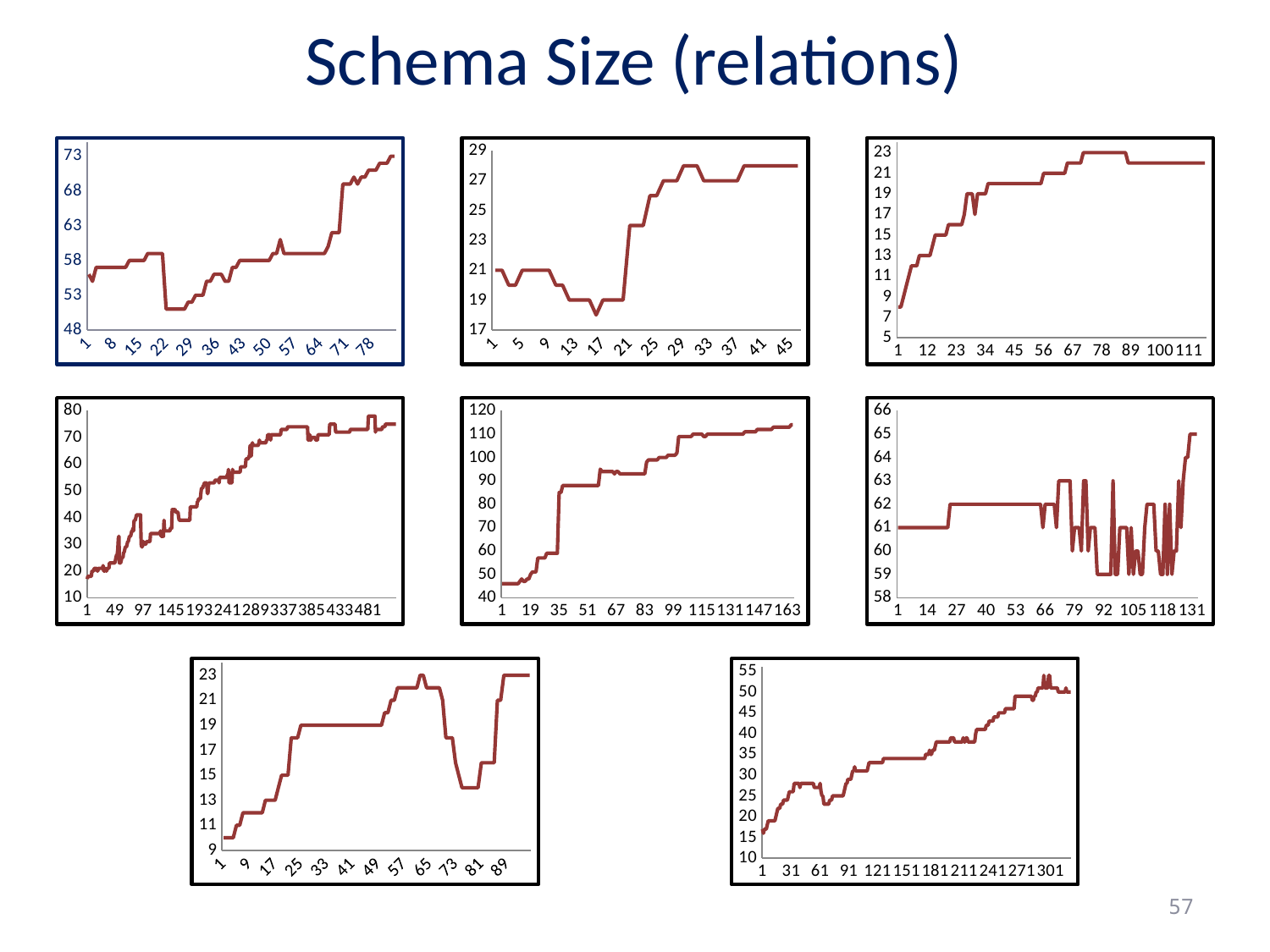
In the bottom-right chart, do the values overall rise or fall from left to right along the x axis? rise In the top-right chart, is the value at x = 1 greater or less than 9? less In the bottom-left chart, is the value at x = 1 greater or less than 11? less In the top-left chart, is the value at x = 1 greater or less than 58? less How many charts are shown on the slide? 8 In the middle-left chart, do the values overall rise or fall from left to right along the x axis? rise What is the title of the slide containing the charts? Schema Size (relations) What kind of chart is the top-left chart on the slide? line chart In the top-left chart, do the values overall rise or fall from left to right along the x axis? rise